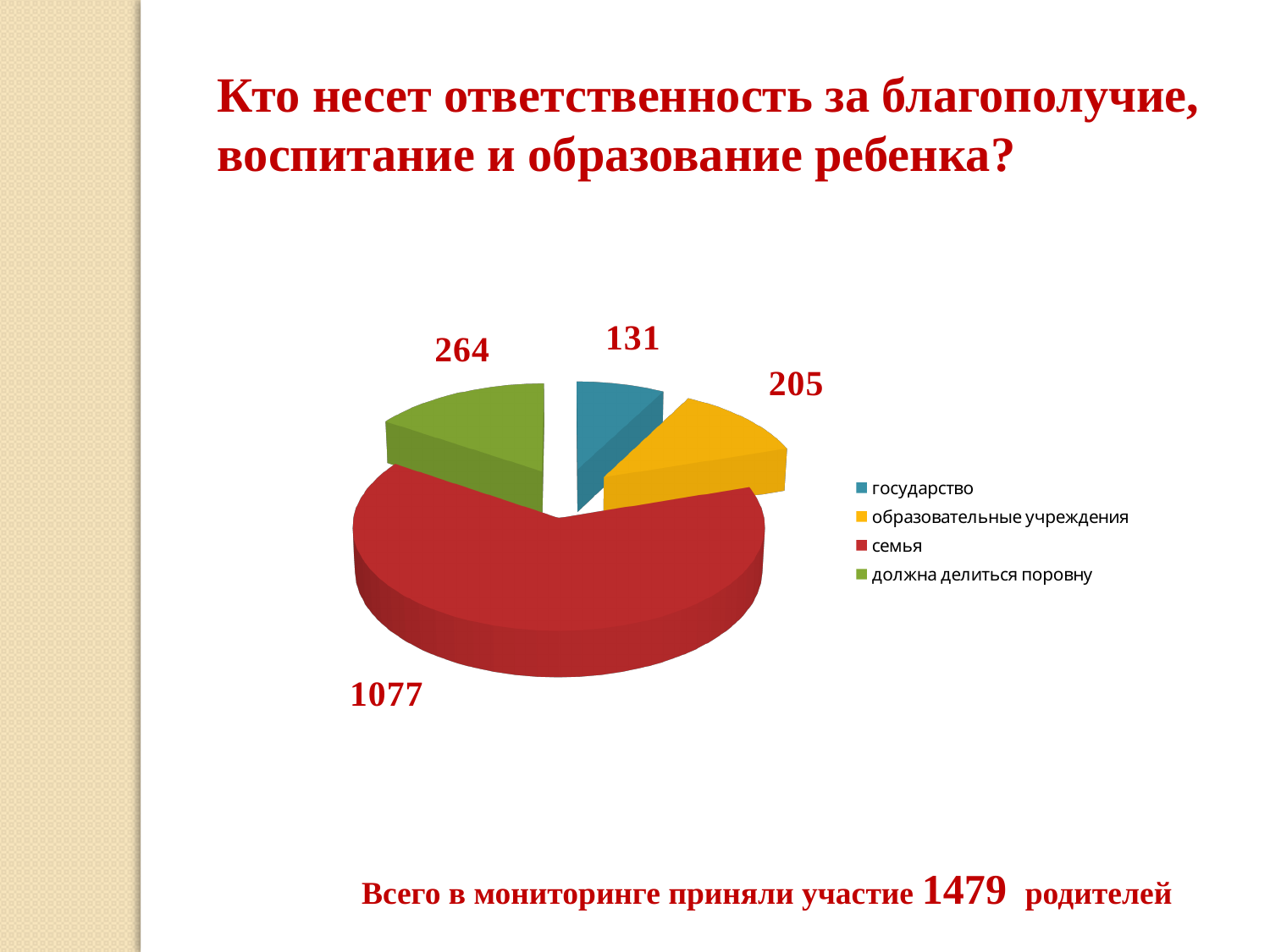
Which category has the largest slice? семья What is the value for образовательные учреждения? 205 What is the value for семья? 1077 What is the difference between the values for семья and должна делиться поровну? 813 Which is larger, the value for образовательные учреждения or the value for должна делиться поровну? должна делиться поровну What colour is the slice for семья? red Which category has the smallest slice? государство What kind of chart is shown on the slide? pie chart How many slices does the pie chart have? 4 What is the value for государство? 131 What is the value for должна делиться поровну? 264 How many entries does the legend list? 4